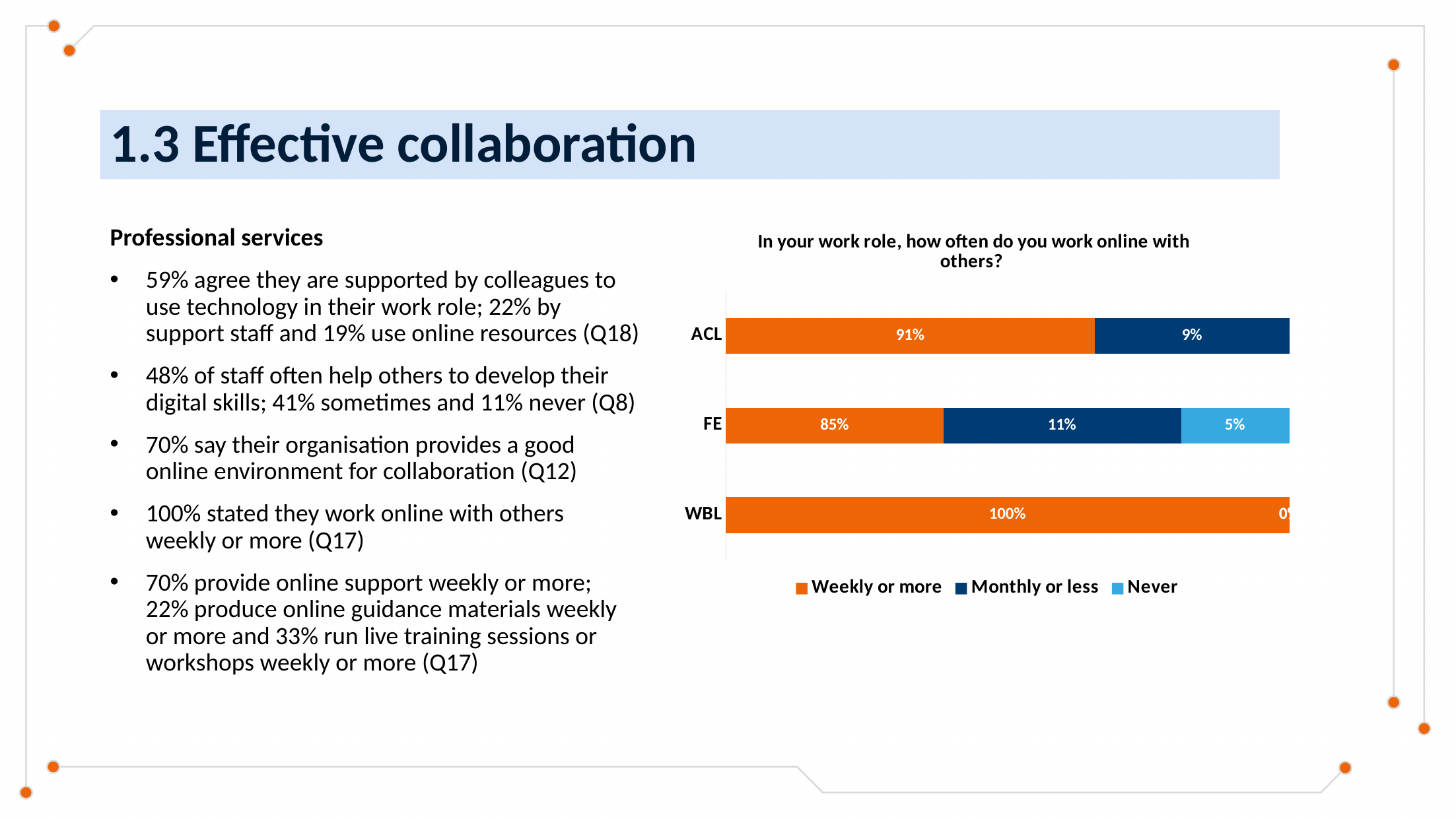
What is the 'Monthly or less' value for FE? 11% What is the difference between the 'Weekly or more' values for ACL and FE? 6% Which category has the highest 'Weekly or more' value? WBL What percentage of ACL respondents work online with others weekly or more? 91% What kind of chart is shown on the slide? Stacked bar chart Which is larger, the 'Monthly or less' value for ACL or for FE? FE What is the 'Monthly or less' value for ACL? 9% How many series does the legend list? 3 What is the 'Weekly or more' value for WBL? 100% What is the 'Never' value for FE? 5% How many categories are shown on the chart? 3 Which category has the lowest 'Weekly or more' value? FE